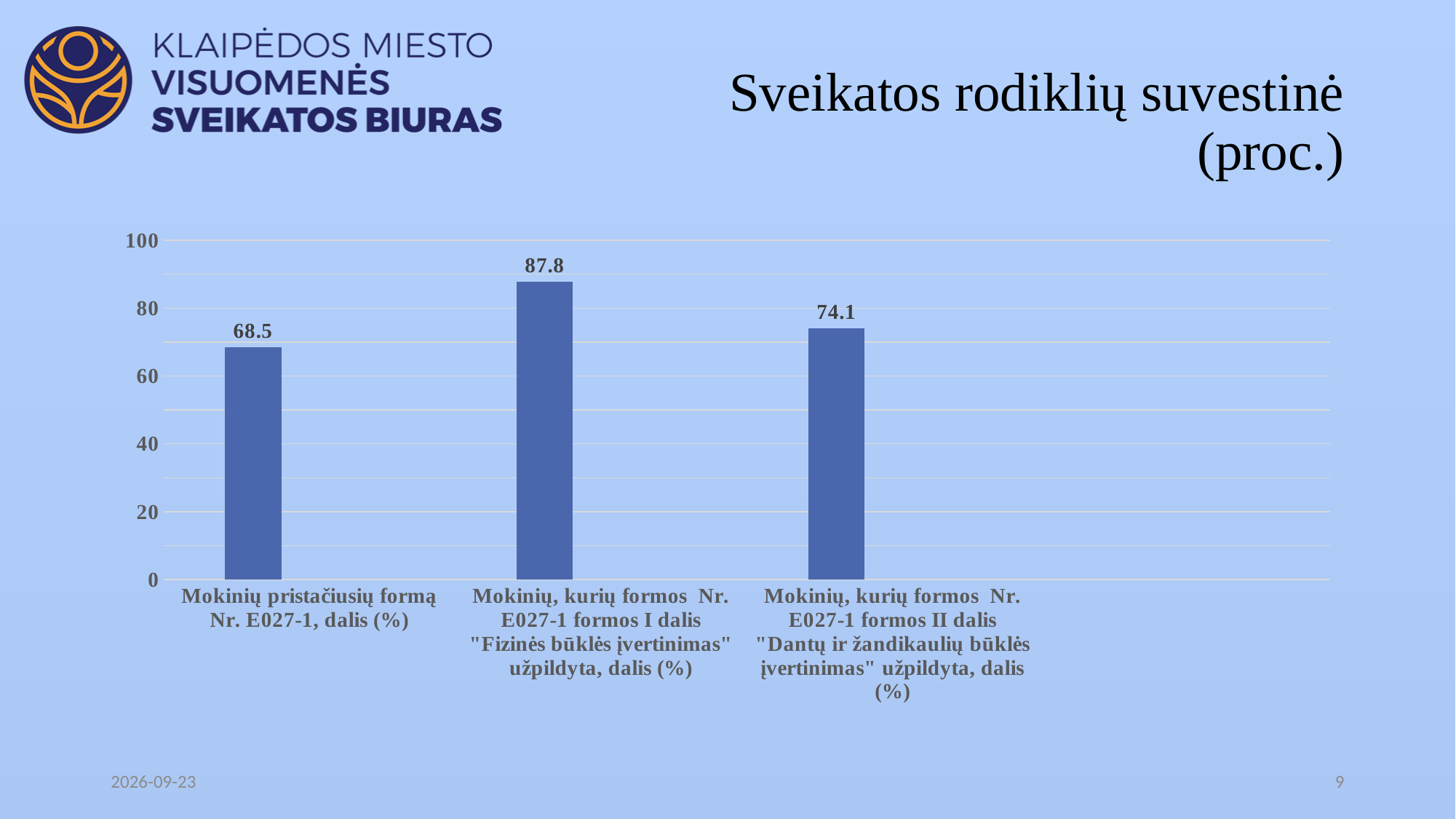
Is the value for "Mokinių pristačiusių formą Nr. E027-1, dalis (%)" greater or less than 80? less Which category has the lowest value? Mokinių pristačiusių formą Nr. E027-1, dalis (%) Which is larger: the value for "Mokinių pristačiusių formą Nr. E027-1" or the value for formos II dalis "Dantų ir žandikaulių būklės įvertinimas"? Formos II dalis "Dantų ir žandikaulių būklės įvertinimas" (74.1) What is the difference between the value for formos I dalis (87.8) and the value for formos II dalis (74.1)? 13.7 What is the value for "Mokinių pristačiusių formą Nr. E027-1, dalis (%)"? 68.5 What is the value for the category about formos II dalis "Dantų ir žandikaulių būklės įvertinimas" užpildyta? 74.1 What is the title of the slide containing the chart? Sveikatos rodiklių suvestinė (proc.) Which category has the highest value? Mokinių, kurių formos Nr. E027-1 formos I dalis "Fizinės būklės įvertinimas" užpildyta, dalis (%) What kind of chart is shown on the slide? Bar chart How many categories are shown on the chart? 3 What is the difference between the highest and lowest values on the chart? 19.3 What is the value for the category about formos I dalis "Fizinės būklės įvertinimas" užpildyta? 87.8